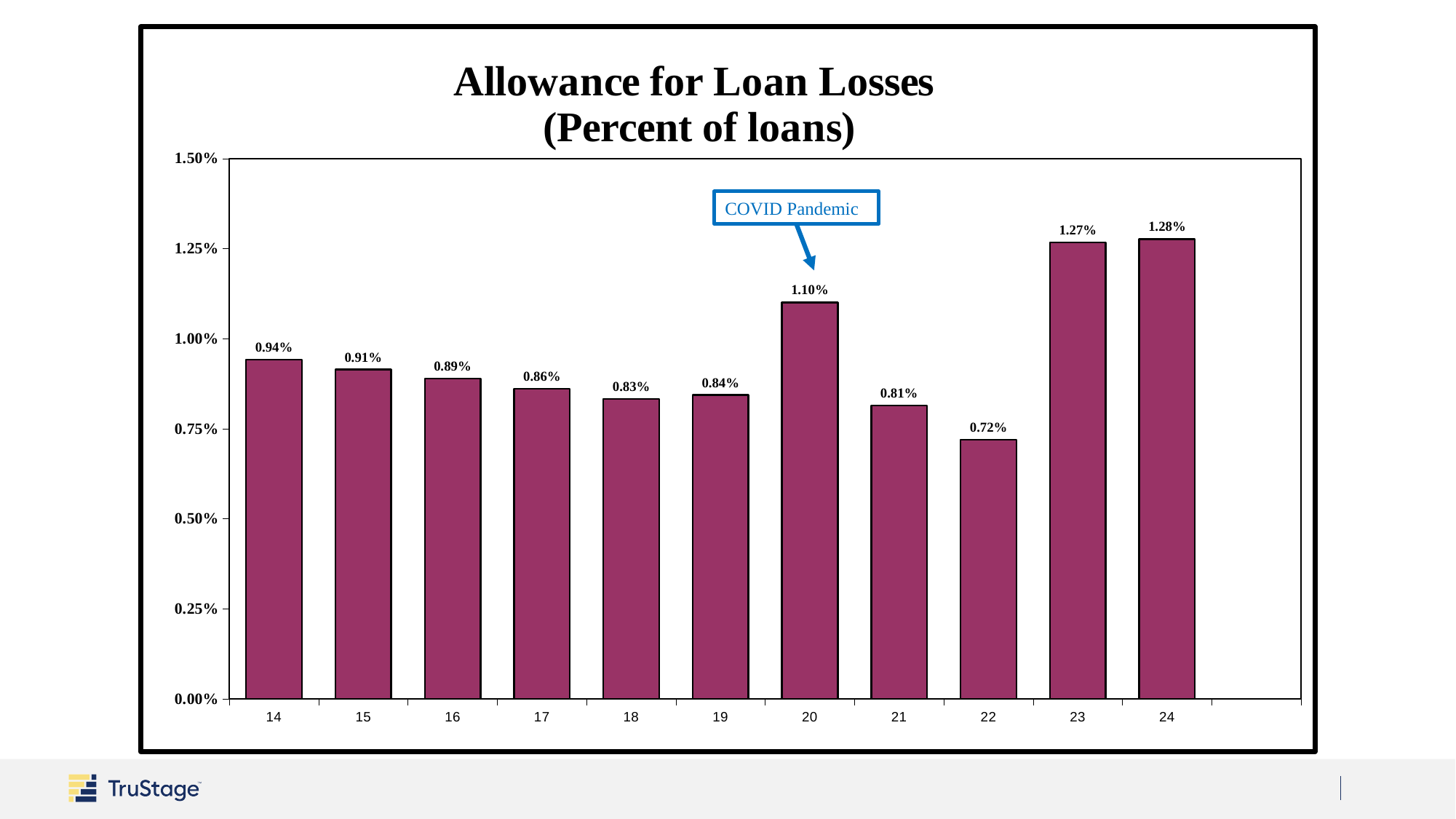
What is the allowance for loan losses in 20? 1.10% Which year does the 'COVID Pandemic' annotation point to? 20 What kind of chart is shown on the slide? bar chart How many years are shown on the chart? 11 What is the allowance for loan losses in 14? 0.94% Which year has a larger allowance for loan losses, 17 or 20? 20 What is the difference between the allowance for loan losses in 24 and in 22? 0.56% Do the values rise or fall from 14 to 18? fall Which year has the lowest allowance for loan losses? 22 What is the allowance for loan losses in 22? 0.72% Which year has the highest allowance for loan losses? 24 Is the value for 21 greater or less than 1.00%? less